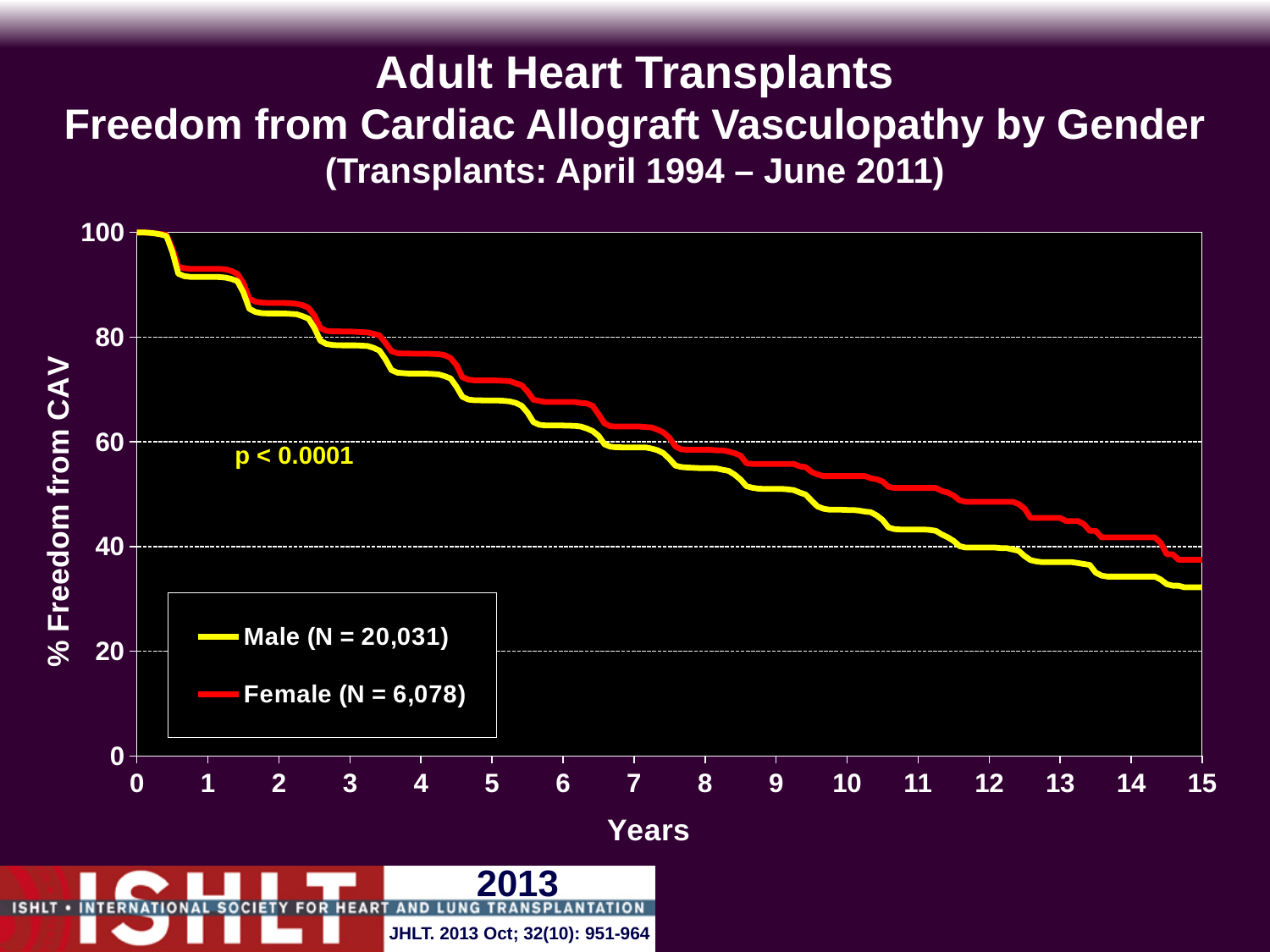
Do the values for the Female series rise or fall as the years increase? fall How many series does the legend list? 2 Is the value for Female at year 15 greater or less than 40? less What is the N shown in the legend for the Male series? 20,031 What kind of chart is shown on the slide? line chart Is the value for Female at year 2 greater or less than 80? greater What p-value is printed on the chart? p < 0.0001 Is the value for Female at year 10 greater or less than 60? less At year 10, which series has the higher % freedom from CAV, Male or Female? Female Do the values for the Male series rise or fall as the years increase? fall